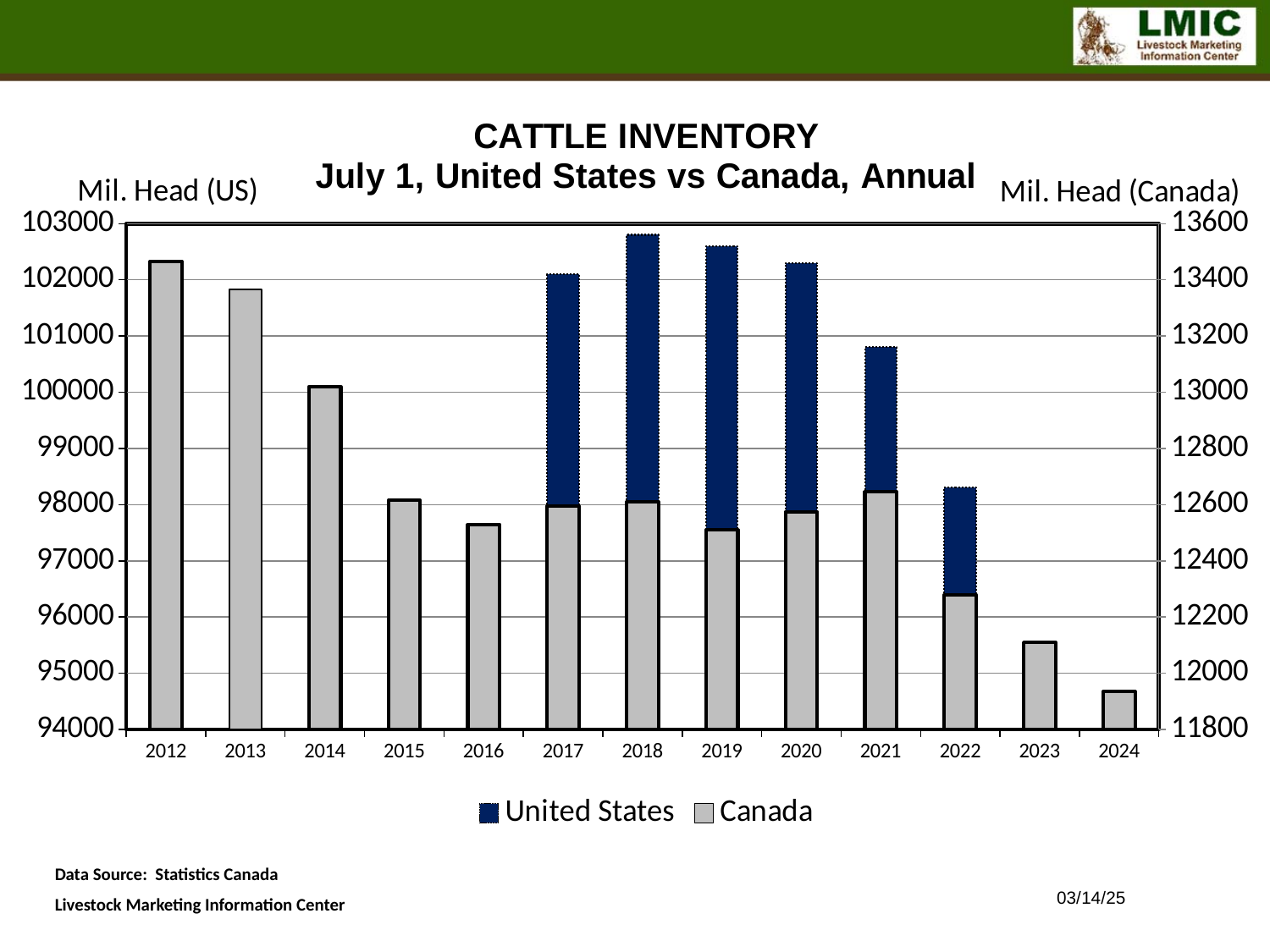
Does the Canada cattle inventory rise or fall from 2021 to 2024? fall Which year has the highest United States cattle inventory? 2018 Which is larger, the Canada value for 2012 or for 2013? 2012 Is the United States value for 2022 greater or less than 99000? less How many series does the legend list? 2 What is the label of the right-hand vertical axis? Mil. Head (Canada) Which year has the lowest Canada cattle inventory? 2024 How many years are shown along the x axis? 13 What kind of chart is shown on the slide? bar chart Is the United States value for 2018 greater or less than 102000? greater Which year has the highest Canada cattle inventory? 2012 Is the Canada value for 2024 greater or less than 12200? less